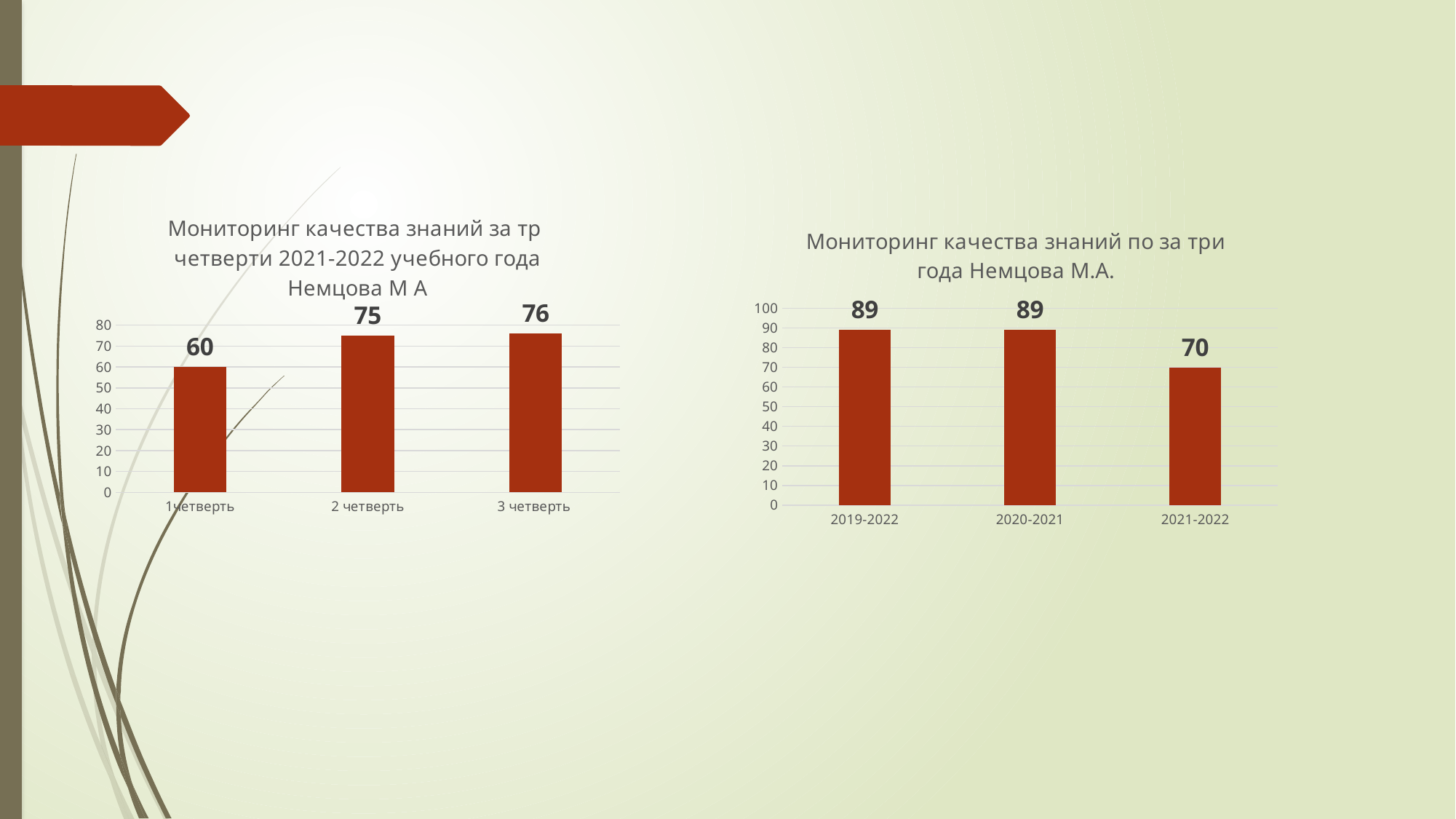
In the left chart (quarters of 2021-2022), what is the value for 3 четверть? 76 In the left chart (quarters of 2021-2022), what is the value for 1 четверть? 60 In the left chart (quarters of 2021-2022), how many bars are plotted? 3 In the right chart (three years), what is the value for 2020-2021? 89 In the left chart (quarters of 2021-2022), do the values rise or fall from 1 четверть to 3 четверть? rise In the left chart (quarters of 2021-2022), what is the difference between 2 четверть and 1 четверть? 15 In the left chart (quarters of 2021-2022), which quarter has the lowest value? 1 четверть What type of chart is the right chart (three years)? bar chart In the right chart (three years), which is larger: the value for 2020-2021 or 2021-2022? 2020-2021 In the right chart (three years), what is the value for 2021-2022? 70 In the right chart (three years), what is the difference between 2019-2022 and 2021-2022? 19 In the right chart (three years), which year has the lowest value? 2021-2022